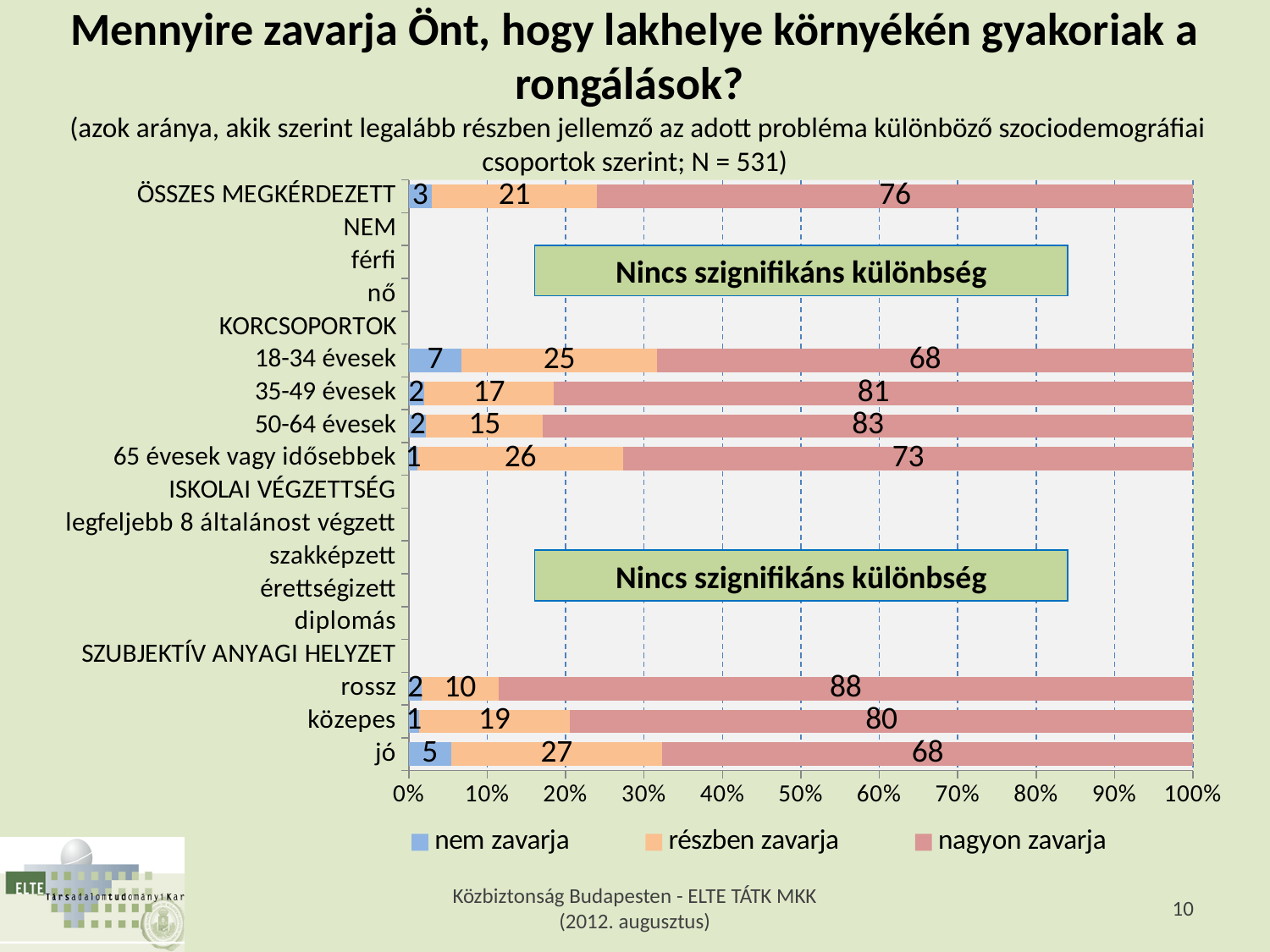
What is the value of "nagyon zavarja" for ÖSSZES MEGKÉRDEZETT? 76 How many series does the legend list? 3 What is the difference between the "nagyon zavarja" values for rossz and jó? 20 What is the value of "nagyon zavarja" for 50-64 évesek? 83 What is the value of "nem zavarja" for jó? 5 Among the age groups, which has the lowest "nagyon zavarja" value? 18-34 évesek What is the total of the three segments for the közepes bar? 100 Among the subjective financial situation groups (rossz, közepes, jó), which has the highest "nagyon zavarja" value? rossz What text appears in the green boxes placed over the NEM and ISKOLAI VÉGZETTSÉG sections of the chart? Nincs szignifikáns különbség Which is larger, the "részben zavarja" value for 65 évesek vagy idősebbek or for 35-49 évesek? 65 évesek vagy idősebbek What is the value of "részben zavarja" for 18-34 évesek? 25 What kind of chart is shown on the slide? Stacked bar chart